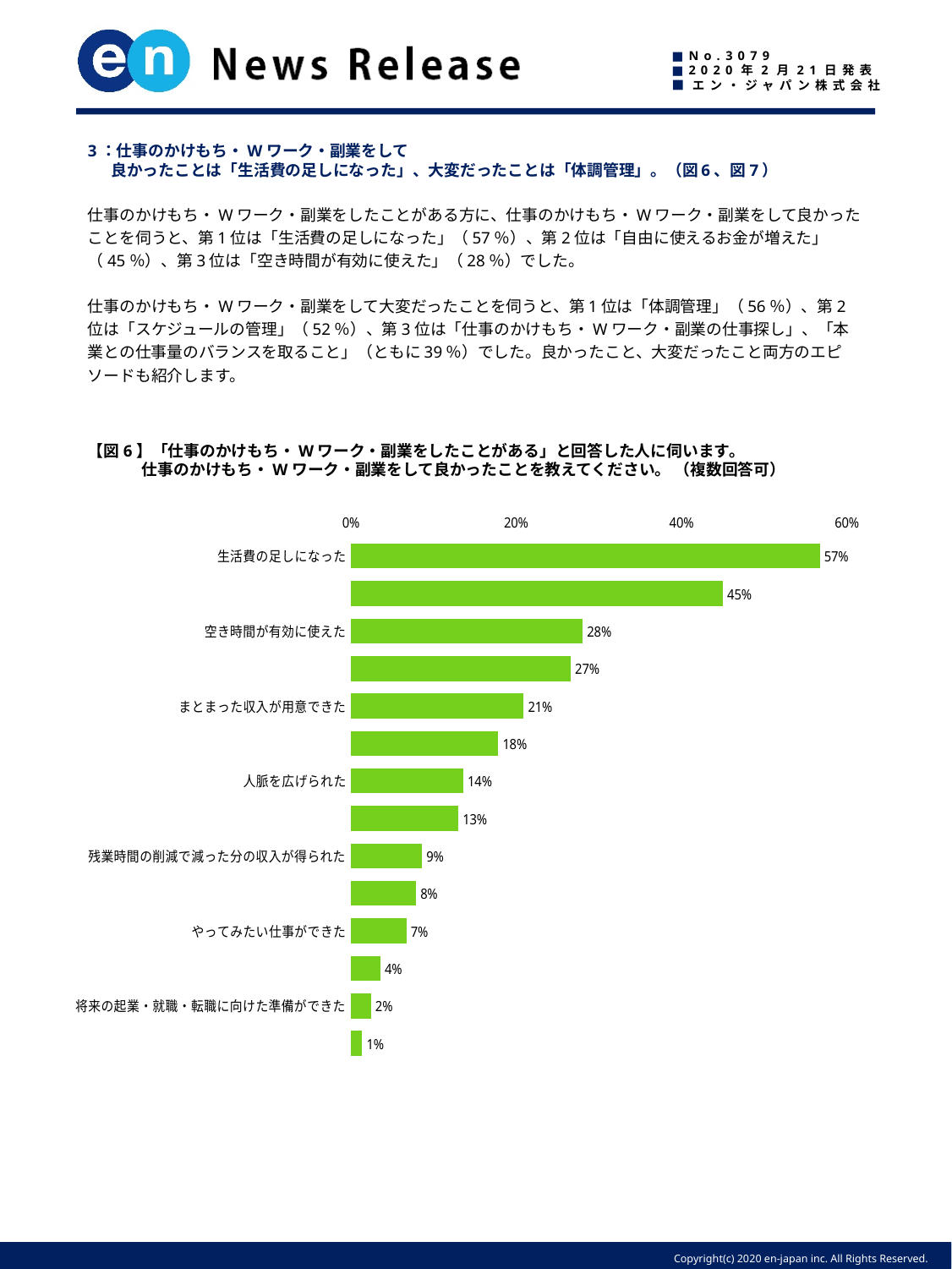
In 図6, which category has the highest value? 生活費の足しになった In 図6, what is the value for 生活費の足しになった? 57% In 図6, what is the difference between 生活費の足しになった and 空き時間が有効に使えた? 29 percentage points What kind of chart is shown in 図6? bar chart In 図6, which is larger: やってみたい仕事ができた or 人脈を広げられた? 人脈を広げられた In 図6, is the value for 生活費の足しになった greater or less than 40%? greater In 図6, what is the value for 将来の起業・就職・転職に向けた準備ができた? 2% How many bars are plotted in 図6? 14 In 図6, what is the value for 空き時間が有効に使えた? 28% In 図6, what is the value for まとまった収入が用意できた? 21% In 図6, what is the value for 人脈を広げられた? 14% In 図6, what is the value for 残業時間の削減で減った分の収入が得られた? 9%